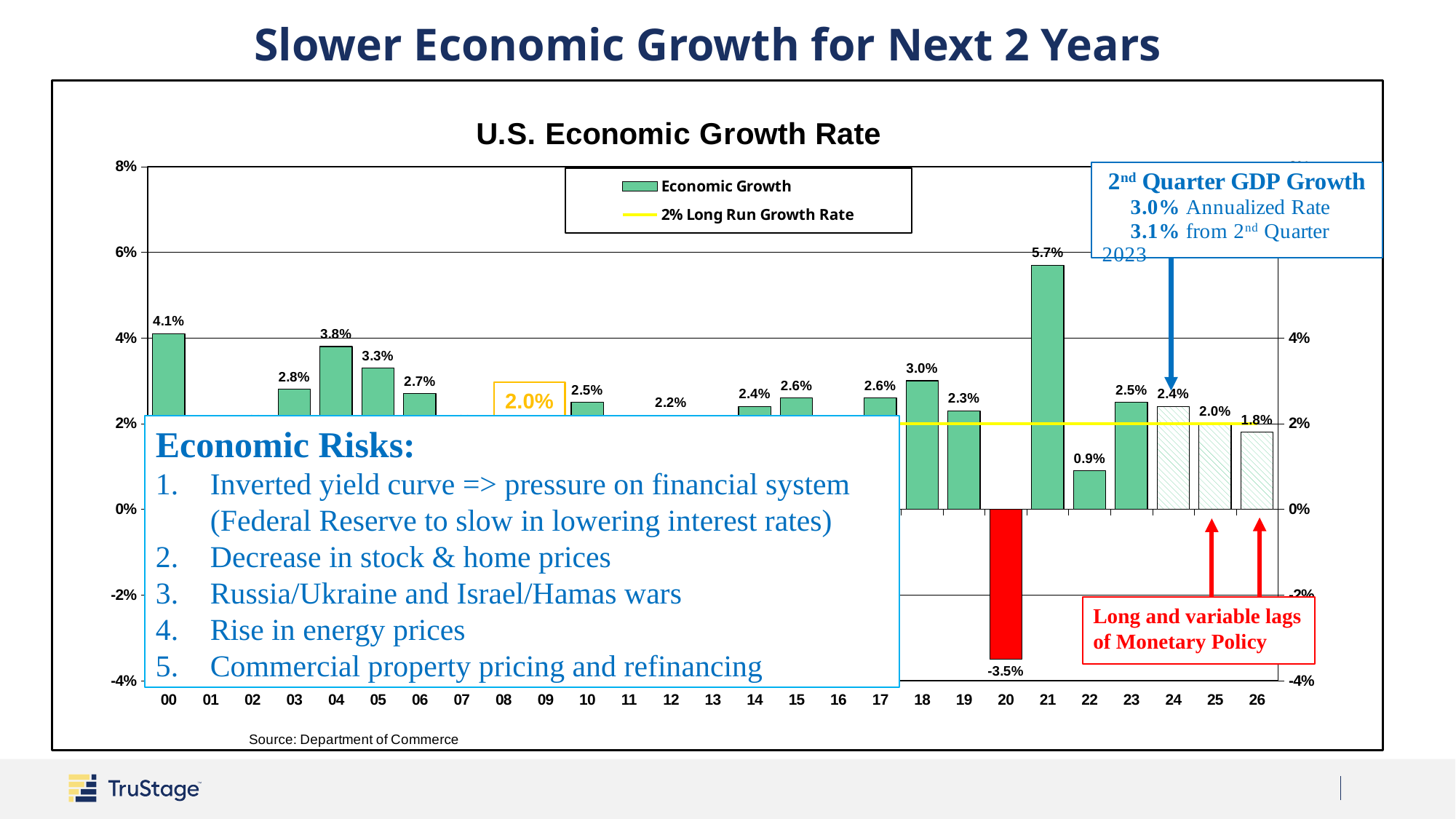
Which year has the highest economic growth rate on the chart? 21 Which year has the higher growth rate, 18 or 19? 18 What is the economic growth rate shown for 2020 (labelled 20)? -3.5% How many series does the legend list? 2 What is the economic growth rate shown for 26? 1.8% Which year has the lowest economic growth rate on the chart? 20 Do the growth rates rise or fall from 24 to 26? Fall What does the yellow line in the chart represent, according to the legend? 2% Long Run Growth Rate What is the U.S. economic growth rate shown for 2021 (labelled 21)? 5.7% What is the difference between the growth rates for 21 and 22? 4.8 percentage points What kind of chart is used to show the economic growth rate? Bar chart What is the difference between the growth rates for 00 and 04? 0.3 percentage points